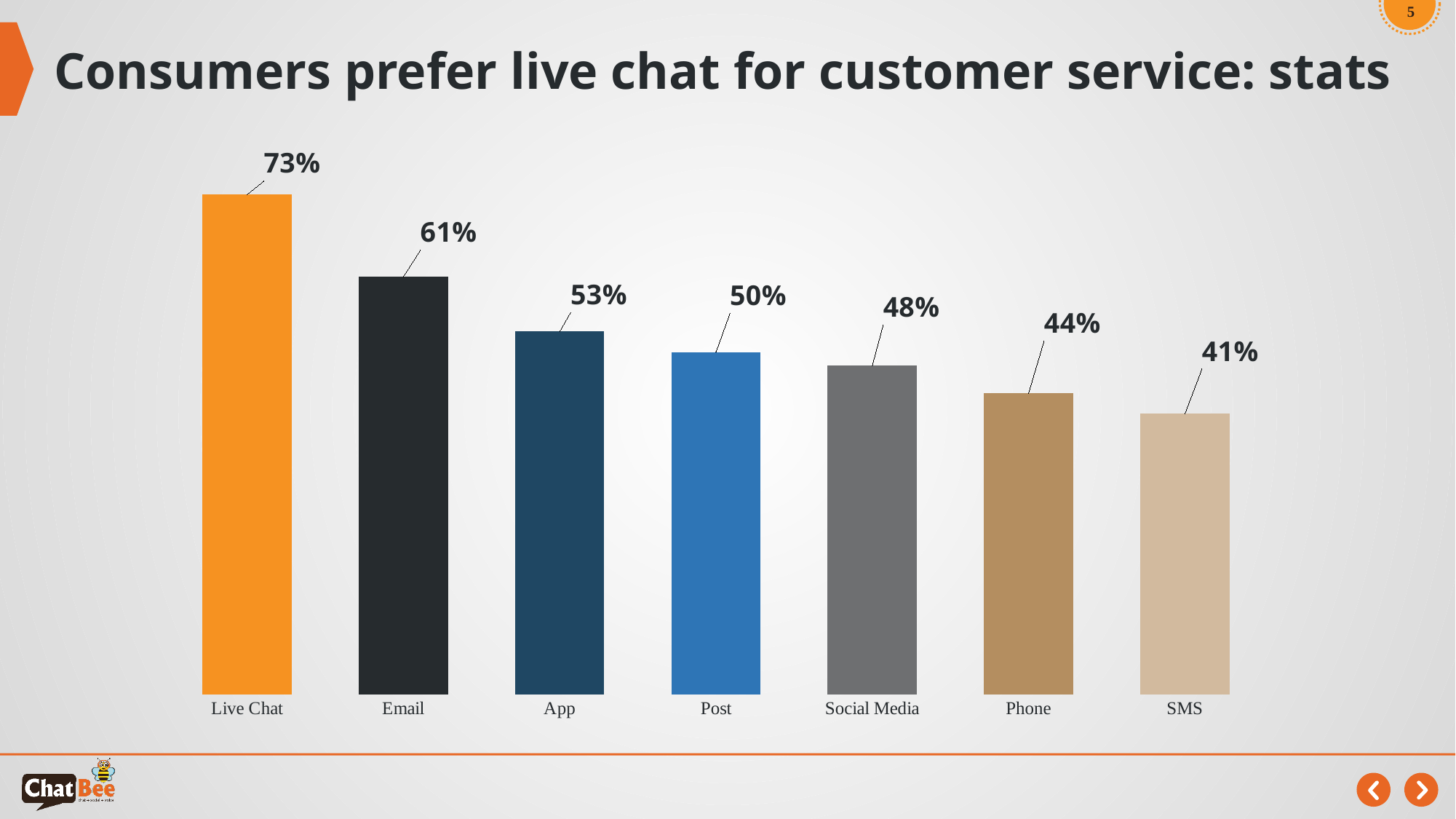
What is the value for Live Chat? 73% What is the value for Social Media? 48% What is the difference between the values for App and Phone? 9% What is the difference between the values for Live Chat and Email? 12% How many categories are shown in the chart? 7 Which category has the highest value? Live Chat What is the value for SMS? 41% What kind of chart is shown on the slide? Bar chart What colour is the Live Chat bar? Orange Which category has the lowest value? SMS Which is larger, the value for Post or the value for Phone? Post Do the values rise or fall from left to right across the categories? Fall